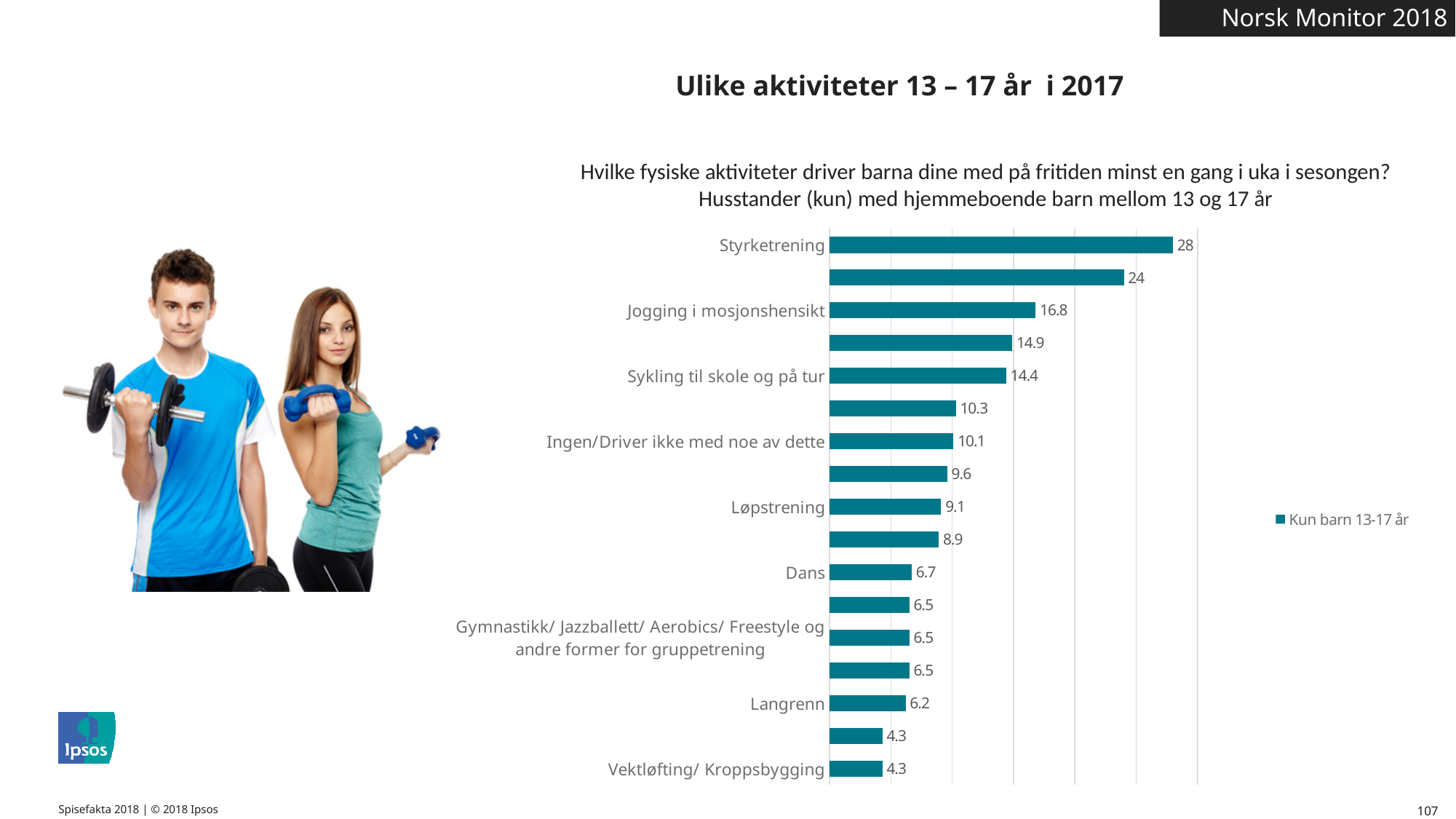
What kind of chart is shown on the slide? Bar chart Which has a larger value, Løpstrening or Dans? Løpstrening What is the value for Vektløfting/ Kroppsbygging? 4.3 What is the difference between the values for Styrketrening and Jogging i mosjonshensikt? 11.2 What is the value for Sykling til skole og på tur? 14.4 What is the value for Styrketrening? 28 Which activity has the highest value? Styrketrening What is the lowest value shown in the chart? 4.3 What is the difference between the values for Sykling til skole og på tur and Langrenn? 8.2 How many bars are plotted in the chart? 17 What is the value for Jogging i mosjonshensikt? 16.8 What is the value for Ingen/Driver ikke med noe av dette? 10.1